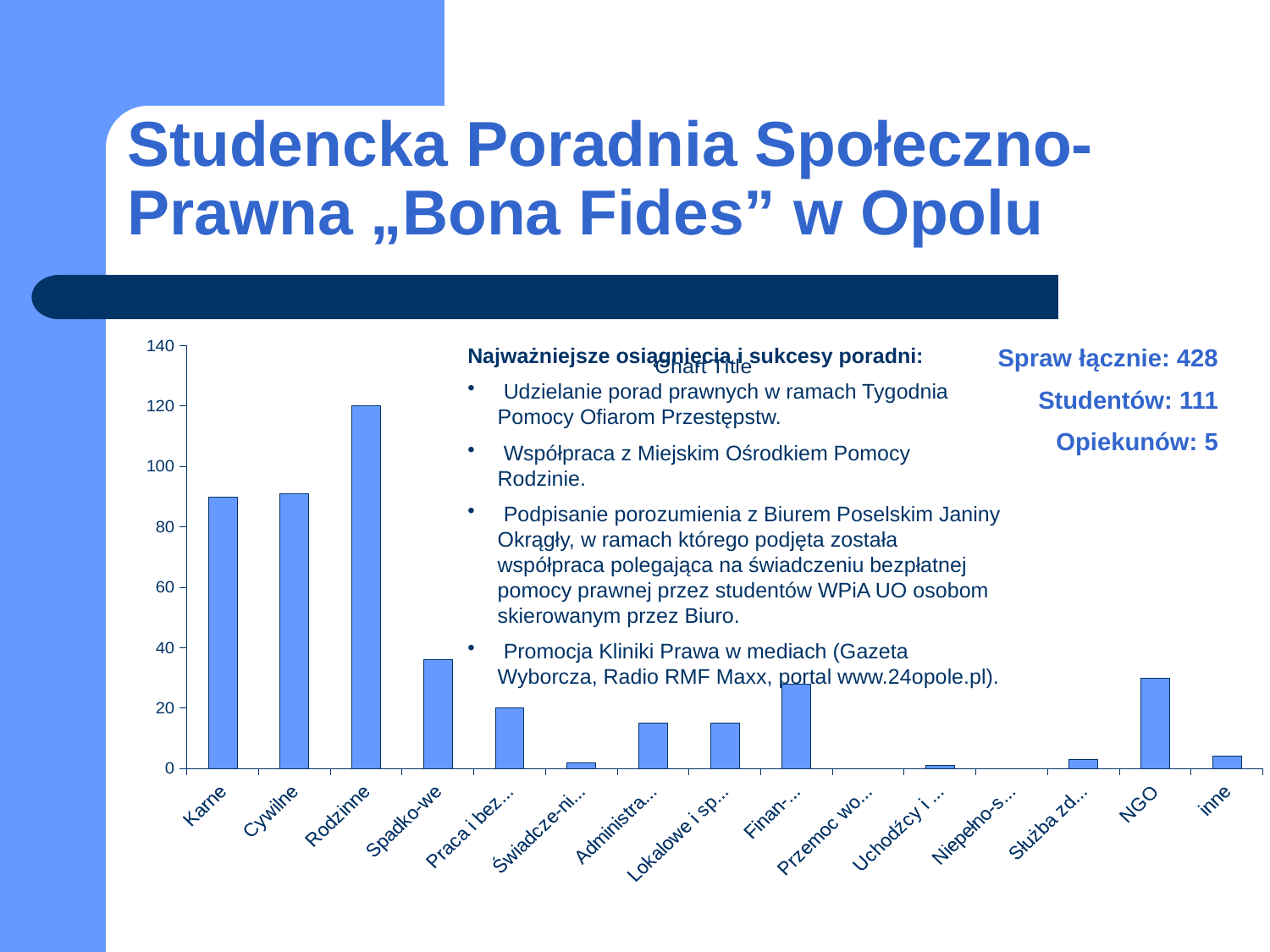
Which is larger, the value for Rodzinne or the value for Karne? Rodzinne What is the title shown on the chart? Chart Title Which category has the highest bar in the chart? Rodzinne What is the value for Rodzinne? 120 Is the value for Świadcze-ni... greater or less than 20? less Is the value for Spadko-we greater or less than 40? less Is the value for Karne greater or less than 80? greater What is the value for Praca i bez...? 20 How many categories are shown on the x axis of the chart? 15 What kind of chart is shown on the slide? bar chart Which is larger, the value for Finan-... or the value for Administra...? Finan-...